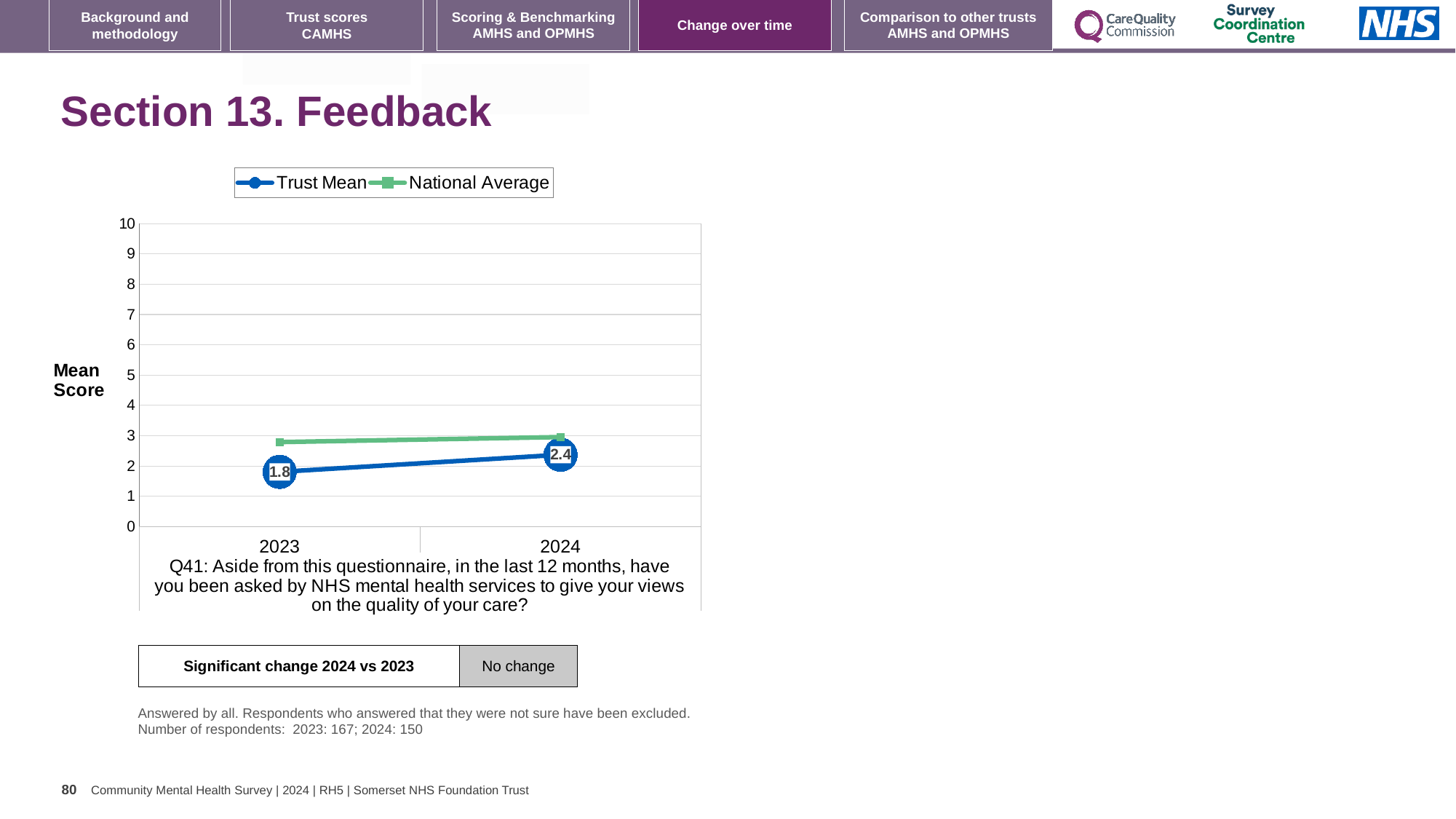
In 2024, which is larger, the Trust Mean or the National Average? National Average Which year has the lower Trust Mean score? 2023 Which year has the higher Trust Mean score, 2023 or 2024? 2024 In 2023, which is larger, the Trust Mean or the National Average? National Average Does the Trust Mean rise or fall from 2023 to 2024? rise What is the Trust Mean score for 2023? 1.8 How many series does the legend list? 2 Is the National Average value for 2023 greater or less than 2? greater What kind of chart is shown on the slide? line chart What is the Trust Mean score for 2024? 2.4 What label is shown on the vertical axis of the chart? Mean Score By how much did the Trust Mean change from 2023 to 2024? 0.6